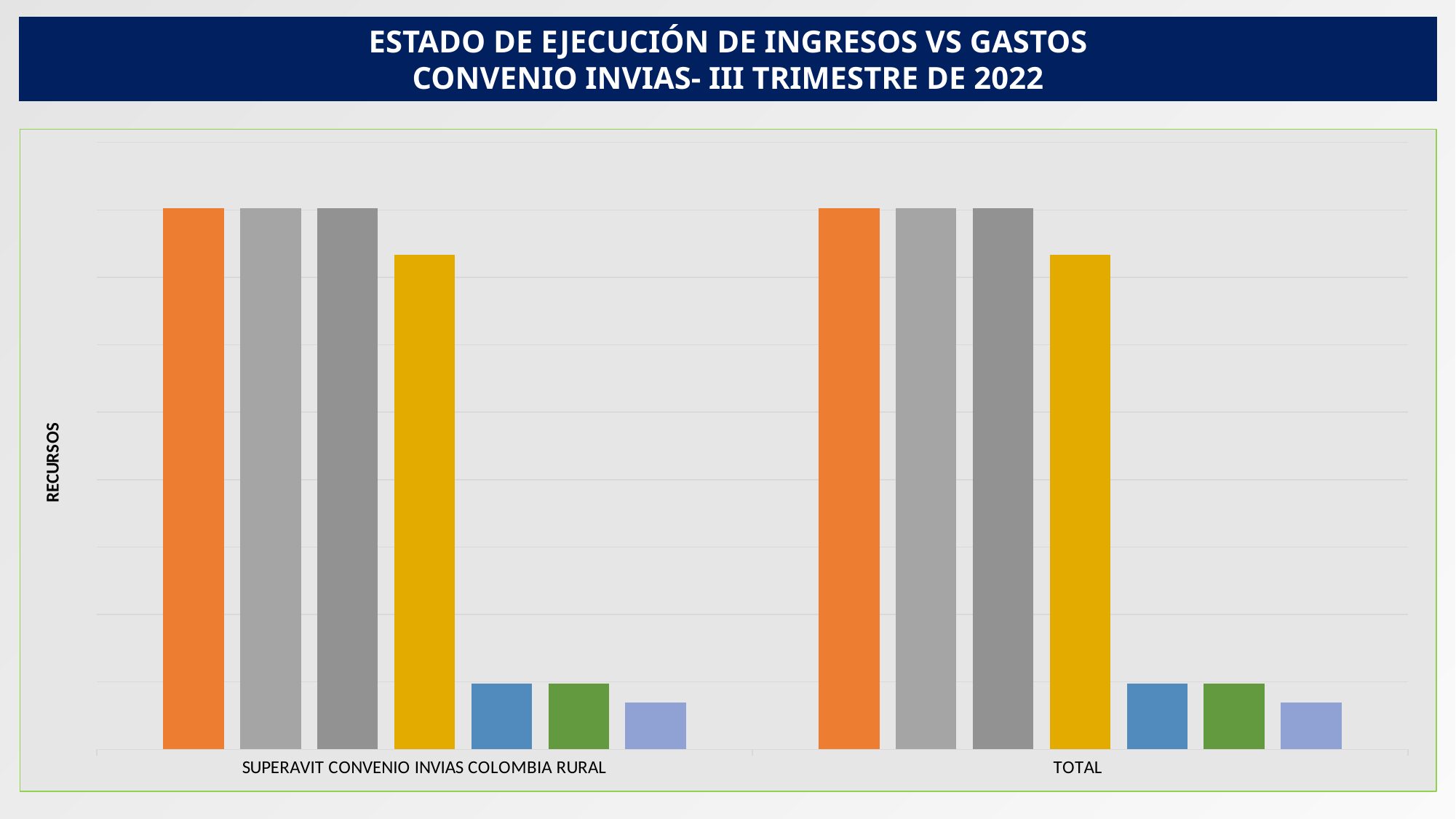
How many categories are shown on the x axis of the chart? 2 In the TOTAL category, is the orange bar or the blue bar taller? The orange bar In the SUPERAVIT CONVENIO INVIAS COLOMBIA RURAL category, is the yellow bar or the green bar taller? The yellow bar What kind of chart is shown on the slide? Bar chart What is the title of the chart on the slide? ESTADO DE EJECUCIÓN DE INGRESOS VS GASTOS CONVENIO INVIAS- III TRIMESTRE DE 2022 How many bars are plotted for the TOTAL category? 7 What are the two category labels on the x axis of the chart? SUPERAVIT CONVENIO INVIAS COLOMBIA RURAL and TOTAL Which colour bar is the shortest in the TOTAL category? The light purple bar